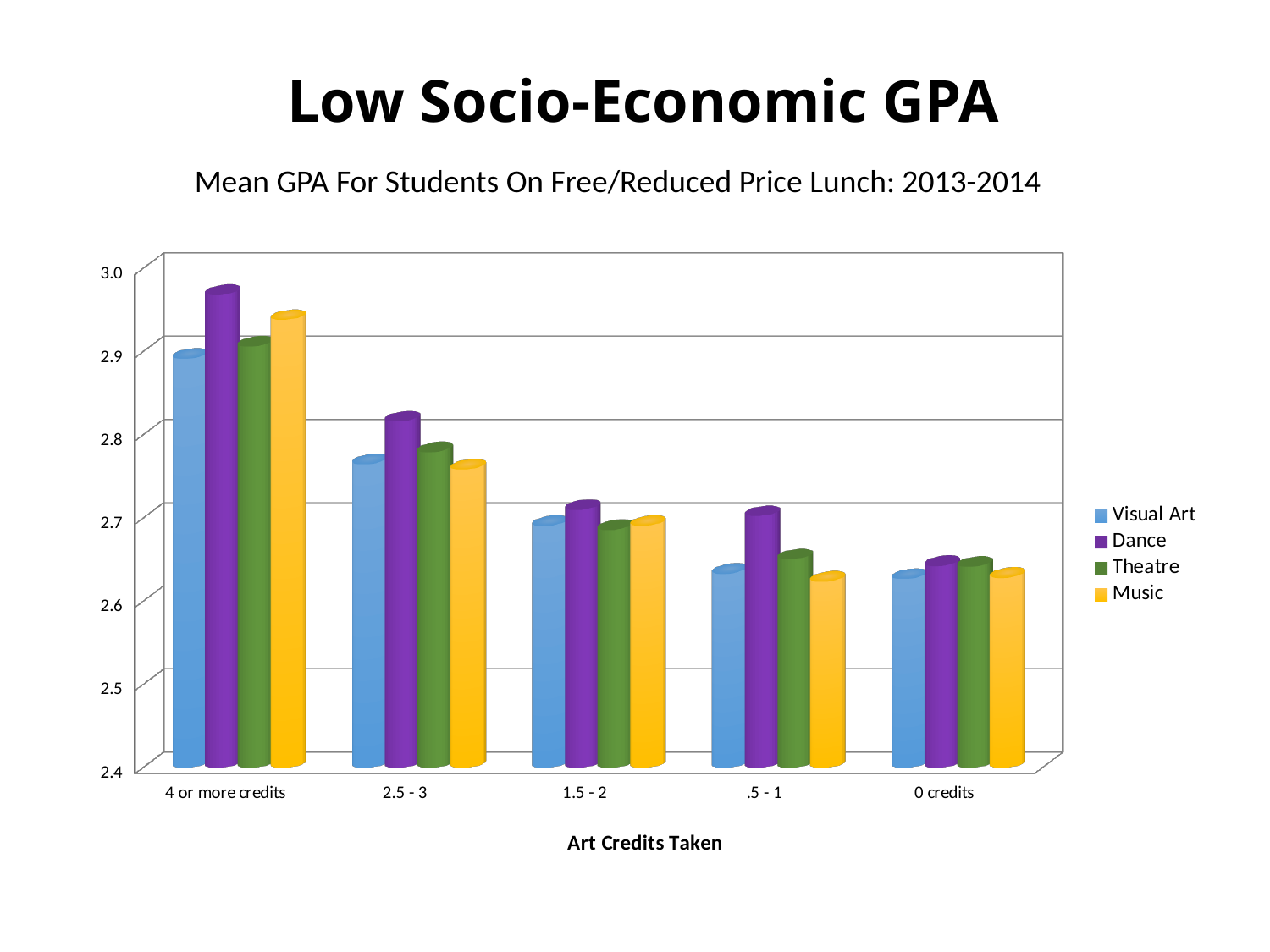
How many series does the legend list? 4 In which category is the Visual Art value lowest? 0 credits Do the Visual Art values rise or fall moving from '4 or more credits' to '0 credits' along the x axis? fall Is the Music value for '.5 - 1' greater or less than 2.7? less Is the Dance value for '4 or more credits' greater or less than 2.9? greater How many art-credit categories are shown on the x axis? 5 Is the Visual Art value for '2.5 - 3' greater or less than 2.8? less What is the title of the x axis? Art Credits Taken Which series has the highest value in the '4 or more credits' category? Dance In the '.5 - 1' category, which is larger, the Dance value or the Visual Art value? Dance In which category is the Dance value highest? 4 or more credits What kind of chart is shown on the slide? bar chart